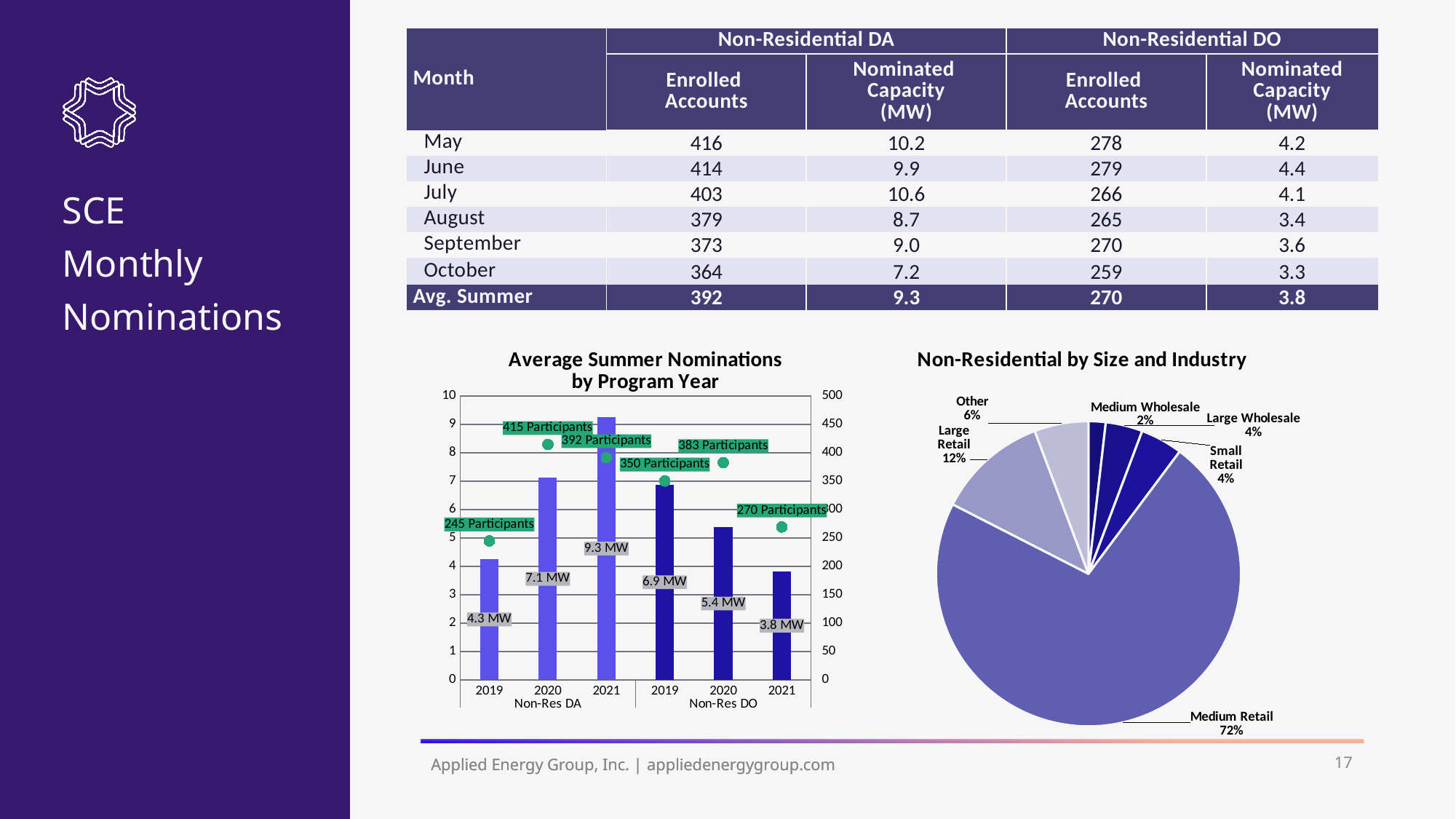
In the Average Summer Nominations by Program Year chart, do the Non-Res DO MW values rise or fall from 2019 to 2021? fall In the Average Summer Nominations by Program Year chart, what is the difference in MW between Non-Res DA 2021 and Non-Res DA 2019? 5.0 MW In the Non-Residential by Size and Industry pie chart, what share does Medium Retail have? 72% In the Non-Residential by Size and Industry pie chart, how many slices are there? 6 In the Average Summer Nominations by Program Year chart, which bar has the lowest MW value? Non-Res DO 2021 In the Average Summer Nominations by Program Year chart, what is the MW value for Non-Res DA in 2021? 9.3 MW In the Non-Residential by Size and Industry pie chart, what is the difference between the Large Retail and Other shares? 6% In the Average Summer Nominations by Program Year chart, which bar has the highest MW value? Non-Res DA 2021 What kind of chart is Average Summer Nominations by Program Year? combination bar and line chart In the Average Summer Nominations by Program Year chart, how many participants are shown for Non-Res DO in 2019? 350 Participants In the Non-Residential by Size and Industry pie chart, which slice is the smallest? Medium Wholesale In the Average Summer Nominations by Program Year chart, how many bars are plotted? 6